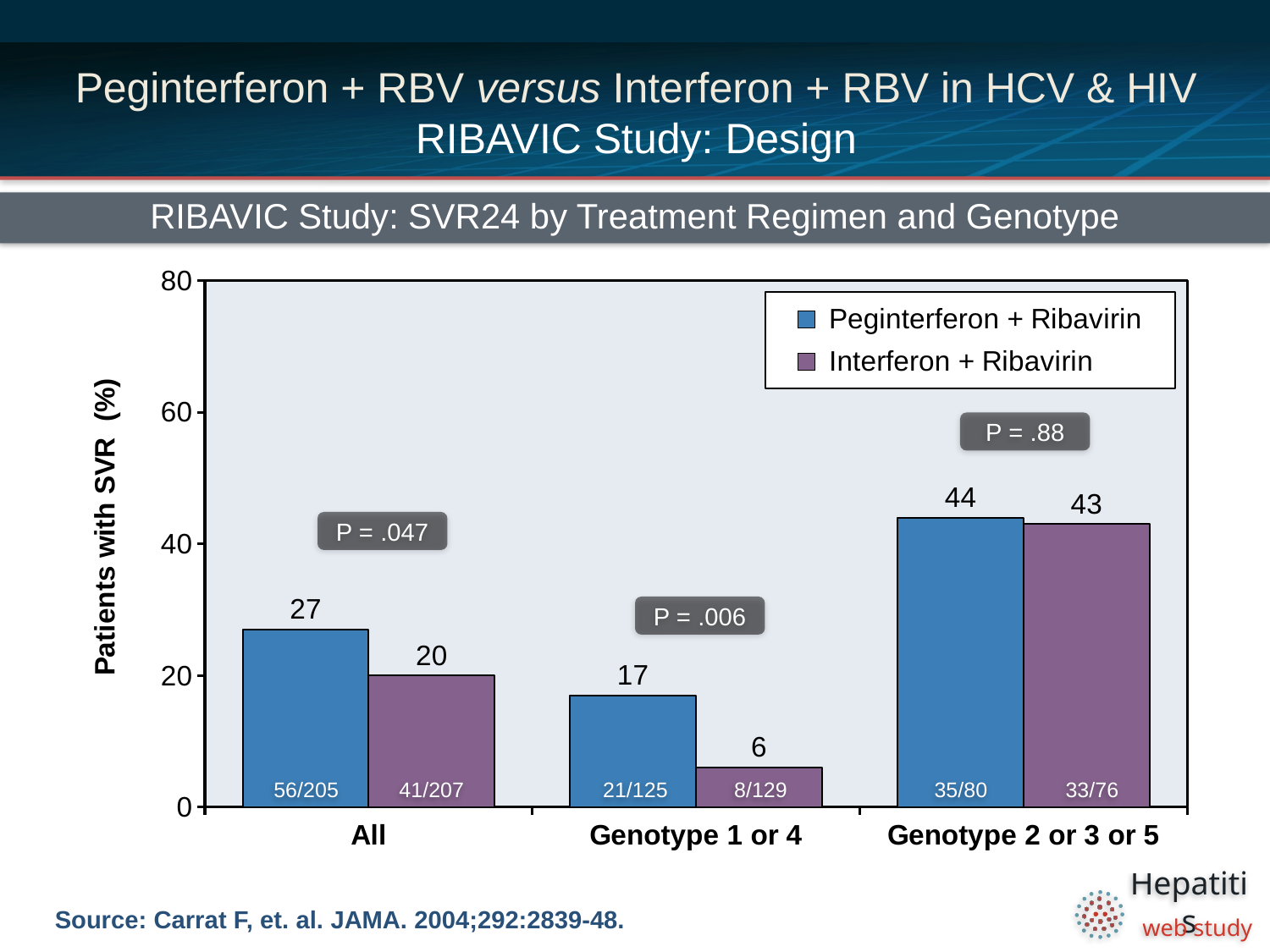
Which genotype group has the highest SVR rate for Peginterferon + Ribavirin? Genotype 2 or 3 or 5 How many genotype groups are shown on the x axis? 3 What is the SVR rate for Interferon + Ribavirin in the Genotype 1 or 4 group? 6 In the All group, which regimen has the higher SVR rate? Peginterferon + Ribavirin Is the SVR rate for Peginterferon + Ribavirin in the Genotype 2 or 3 or 5 group greater or less than 40? greater Which genotype group has the lowest SVR rate for Interferon + Ribavirin? Genotype 1 or 4 What is the SVR rate for Peginterferon + Ribavirin in the All group? 27 What kind of chart is shown on the slide? Bar chart What is the difference between the Peginterferon + Ribavirin and Interferon + Ribavirin SVR rates in the Genotype 1 or 4 group? 11 What P value is shown for the Genotype 2 or 3 or 5 comparison? P = .88 What is the SVR rate for Interferon + Ribavirin in the Genotype 2 or 3 or 5 group? 43 How many series does the legend list? 2